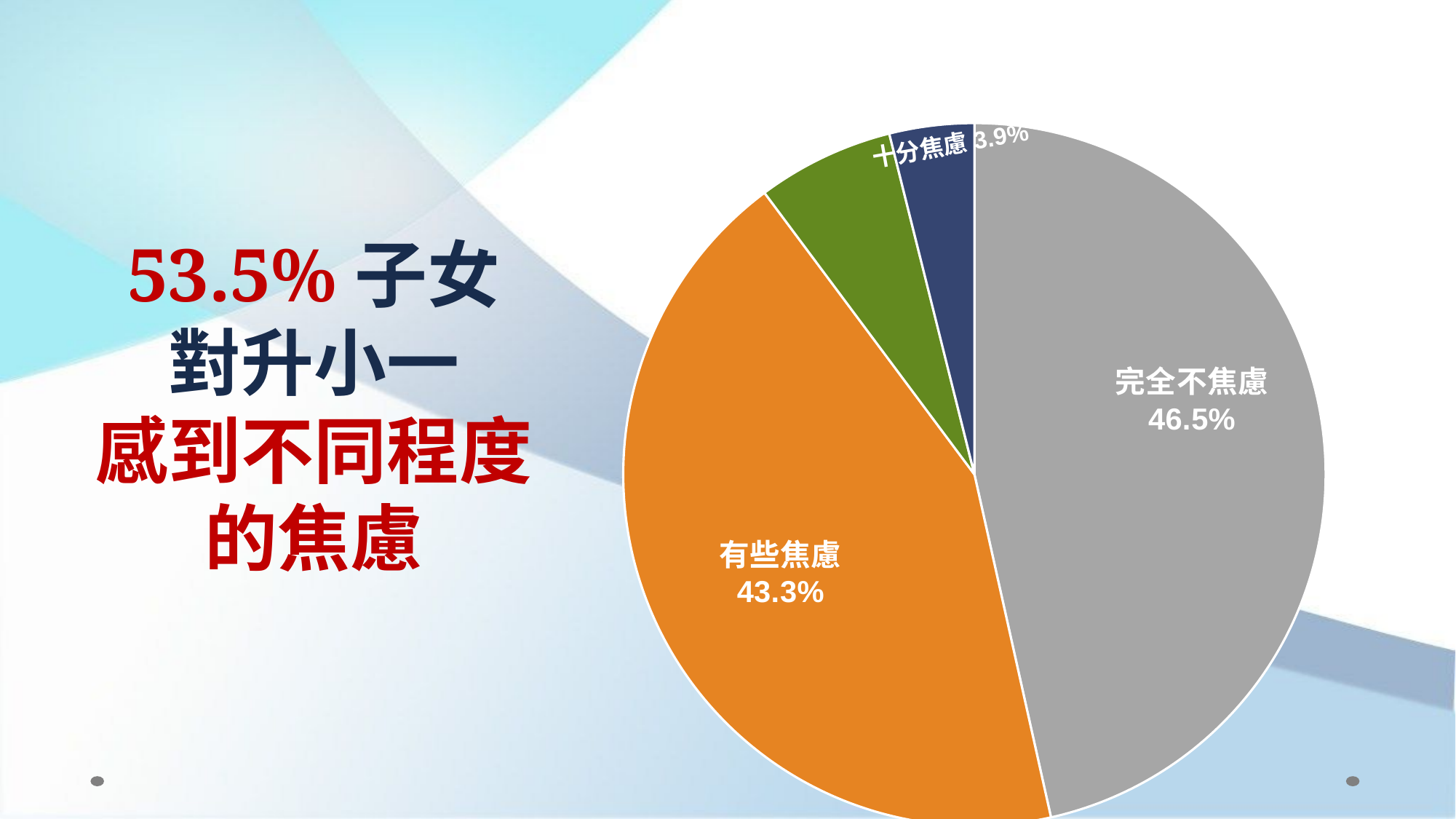
Which category has the largest slice of the pie? 完全不焦慮 What is the combined percentage of 有些焦慮 and 十分焦慮? 47.2% How many slices does the pie chart have? 4 What percentage does the 完全不焦慮 slice show? 46.5% Which labelled category has the smallest slice of the pie? 十分焦慮 Which is larger, the 完全不焦慮 slice or the 有些焦慮 slice? 完全不焦慮 What percentage does the 十分焦慮 slice show? 3.9% What colour is the 有些焦慮 slice? orange What share of the pie does 完全不焦慮 take? 46.5% What percentage does the 有些焦慮 slice show? 43.3% What is the difference in percentage points between 完全不焦慮 and 有些焦慮? 3.2 What kind of chart is shown on the slide? pie chart